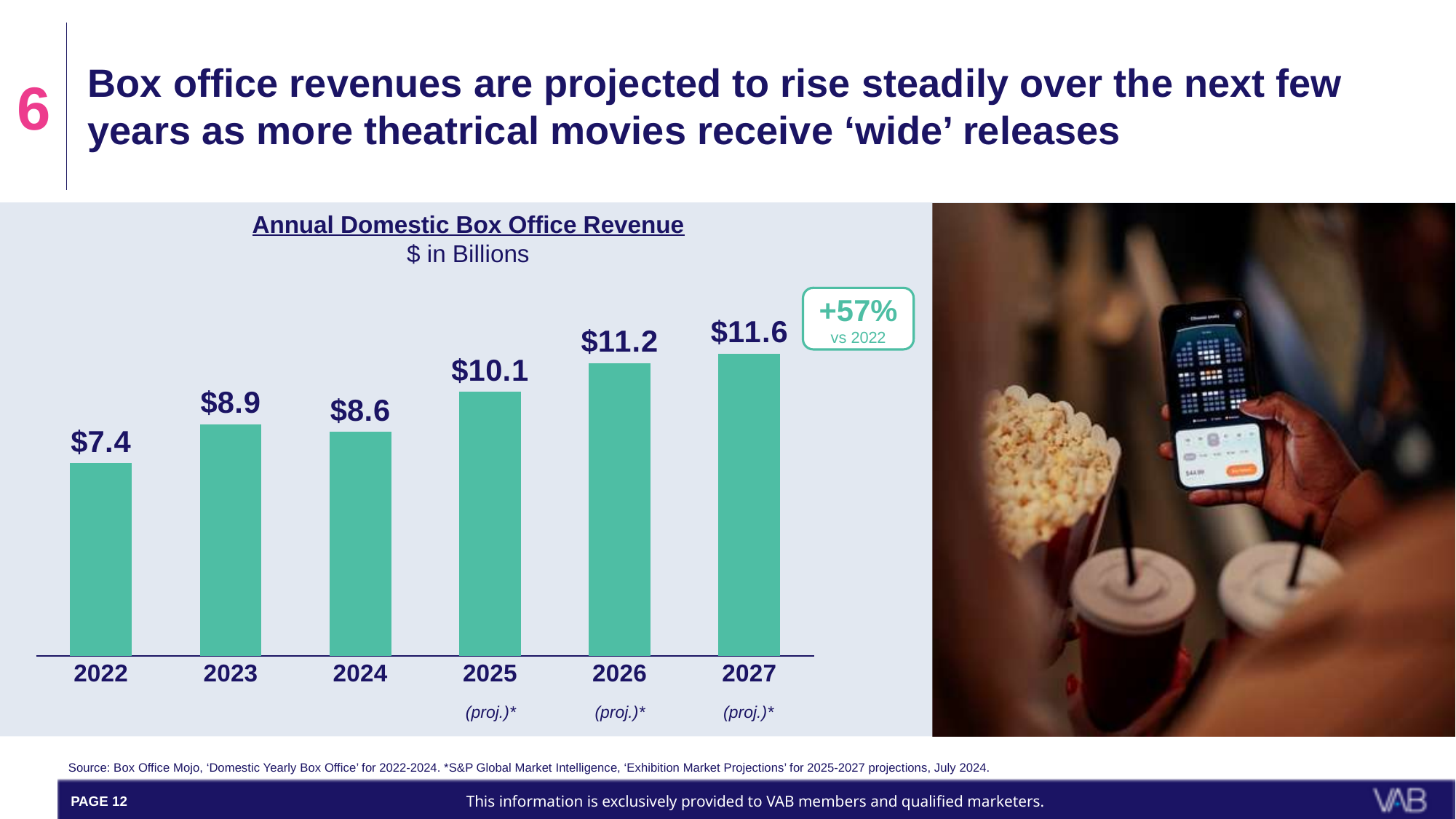
Which year has the larger annual domestic box office revenue, 2023 or 2024? 2023 How many years are shown on the Annual Domestic Box Office Revenue chart? 6 What is the projected annual domestic box office revenue for 2027? $11.6 What is the difference between the 2027 and 2022 annual domestic box office revenue values? $4.2 Which year has the lowest annual domestic box office revenue on the chart? 2022 What kind of chart is used to show Annual Domestic Box Office Revenue? Bar chart What unit is the Annual Domestic Box Office Revenue chart measured in? $ in Billions Which year has the highest annual domestic box office revenue on the chart? 2027 Do the annual domestic box office revenue values generally rise or fall from 2022 to 2027? Rise What is the projected annual domestic box office revenue for 2025? $10.1 What percentage change vs 2022 is shown in the callout next to the 2027 bar? +57% What is the annual domestic box office revenue for 2022? $7.4